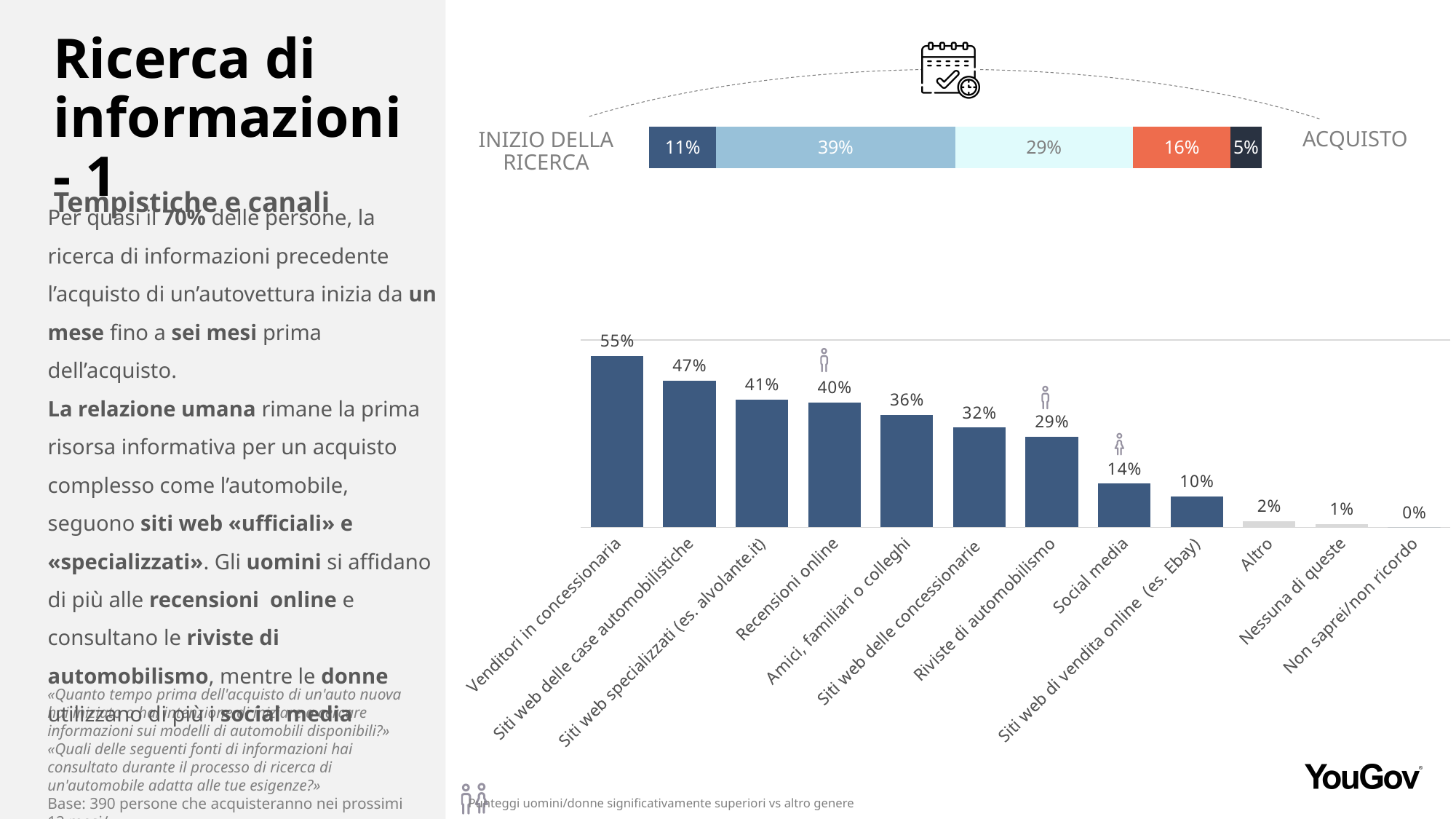
In the bar chart at the bottom, what is the value for Social media? 14% How many categories are shown in the bar chart at the bottom? 12 In the bar chart at the bottom, do the values rise or fall from left to right? Fall In the bar chart at the bottom, which category has the lowest value? Non saprei/non ricordo In the stacked bar at the top of the slide, what is the value of the largest segment? 39% In the bar chart at the bottom, which category has the highest value? Venditori in concessionaria What kind of chart is the chart at the bottom of the slide? Bar chart In the bar chart at the bottom, which is larger: Amici, familiari o colleghi or Recensioni online? Recensioni online In the bar chart at the bottom, what is the value for Venditori in concessionaria? 55% In the bar chart at the bottom, what is the difference between Siti web delle case automobilistiche and Siti web delle concessionarie? 15% How many segments does the stacked bar at the top of the slide contain? 5 In the bar chart at the bottom, what is the value for Riviste di automobilismo? 29%